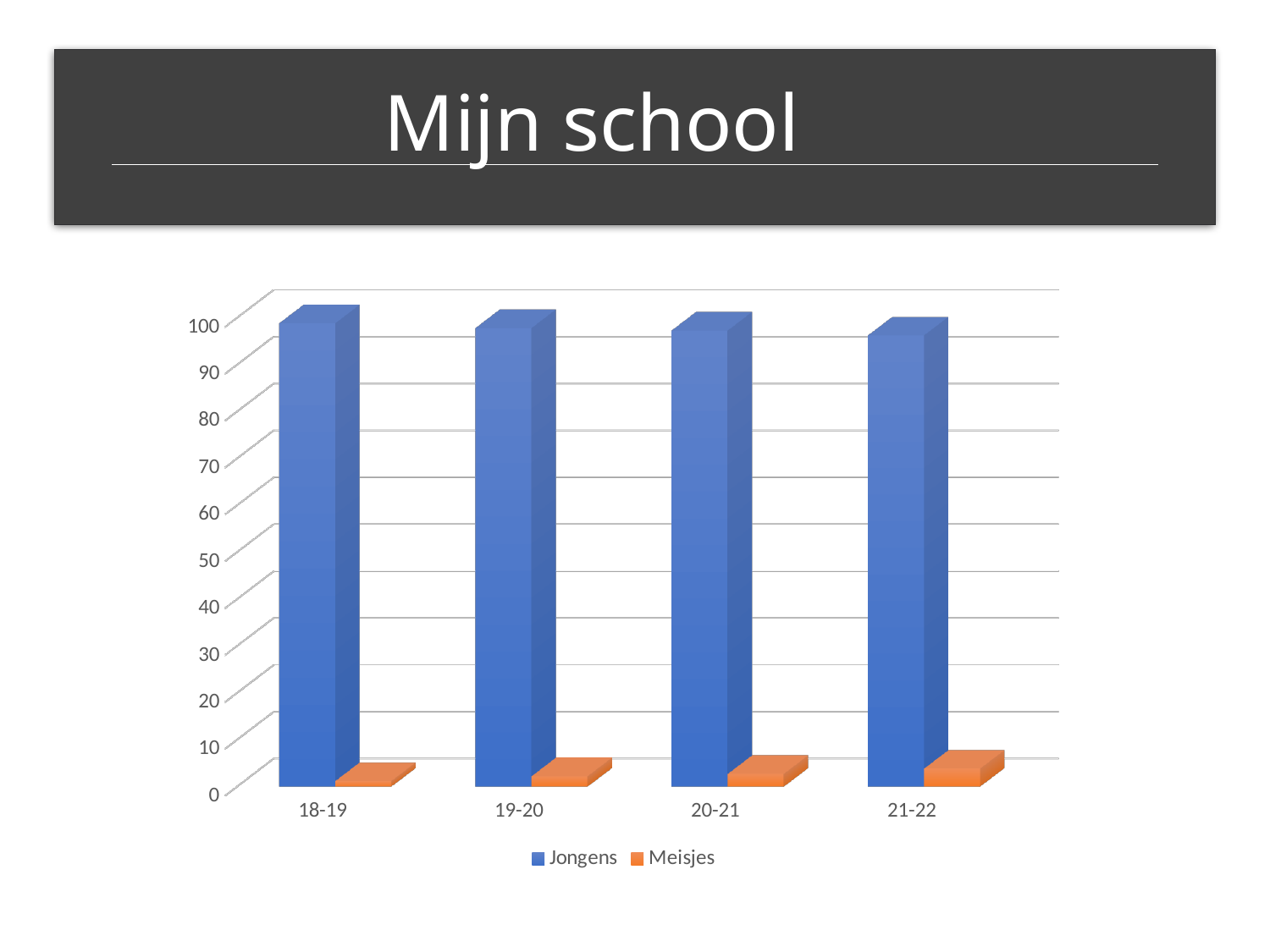
Is the value for Meisjes in 21-22 greater or less than 10? less Do the values for Meisjes rise or fall from 18-19 to 21-22? rise How many series does the legend list? 2 How many categories are shown on the x axis? 4 What kind of chart is shown on the slide? bar chart What are the two series named in the legend? Jongens and Meisjes Is the value for Jongens in 21-22 greater or less than 80? greater What is the title of the slide containing the chart? Mijn school Which category has the highest value for Jongens? 18-19 Do the values for Jongens rise or fall from 18-19 to 21-22? fall Is the value for Jongens in 18-19 greater or less than 90? greater Which is larger in 19-20, Jongens or Meisjes? Jongens